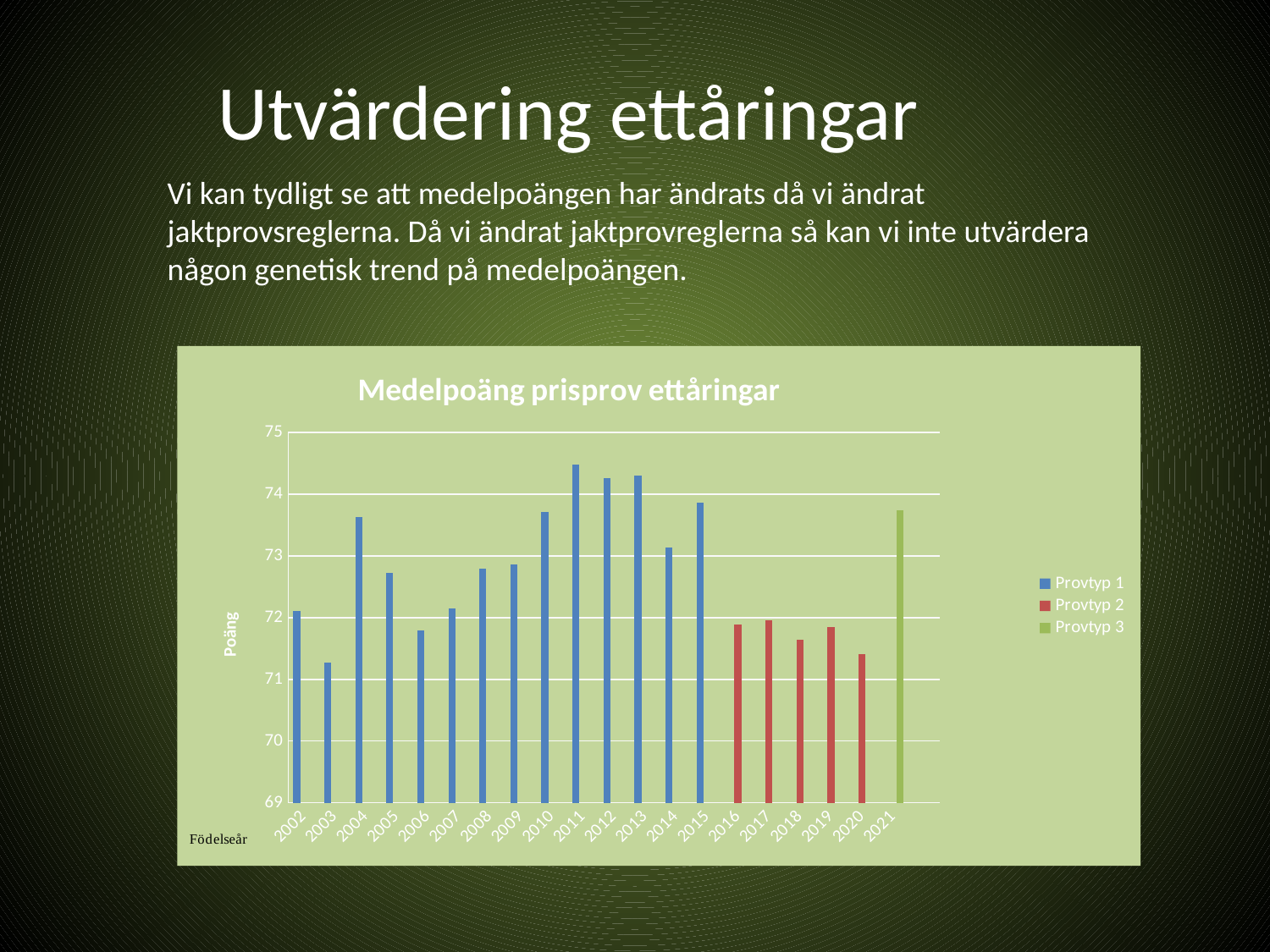
What is the title of the chart? Medelpoäng prisprov ettåringar Which has the larger value, 2015 or 2016? 2015 Which birth year has the highest bar? 2011 How many birth years (categories) are shown on the x axis? 20 Is the value for 2011 greater or less than 74? greater Is the value for 2003 greater or less than 72? less Which has the larger value, 2004 or 2005? 2004 What kind of chart is shown on the slide? bar chart Is the value for 2021 greater or less than 73? greater Which series is shown in red in the legend? Provtyp 2 How many series does the legend list? 3